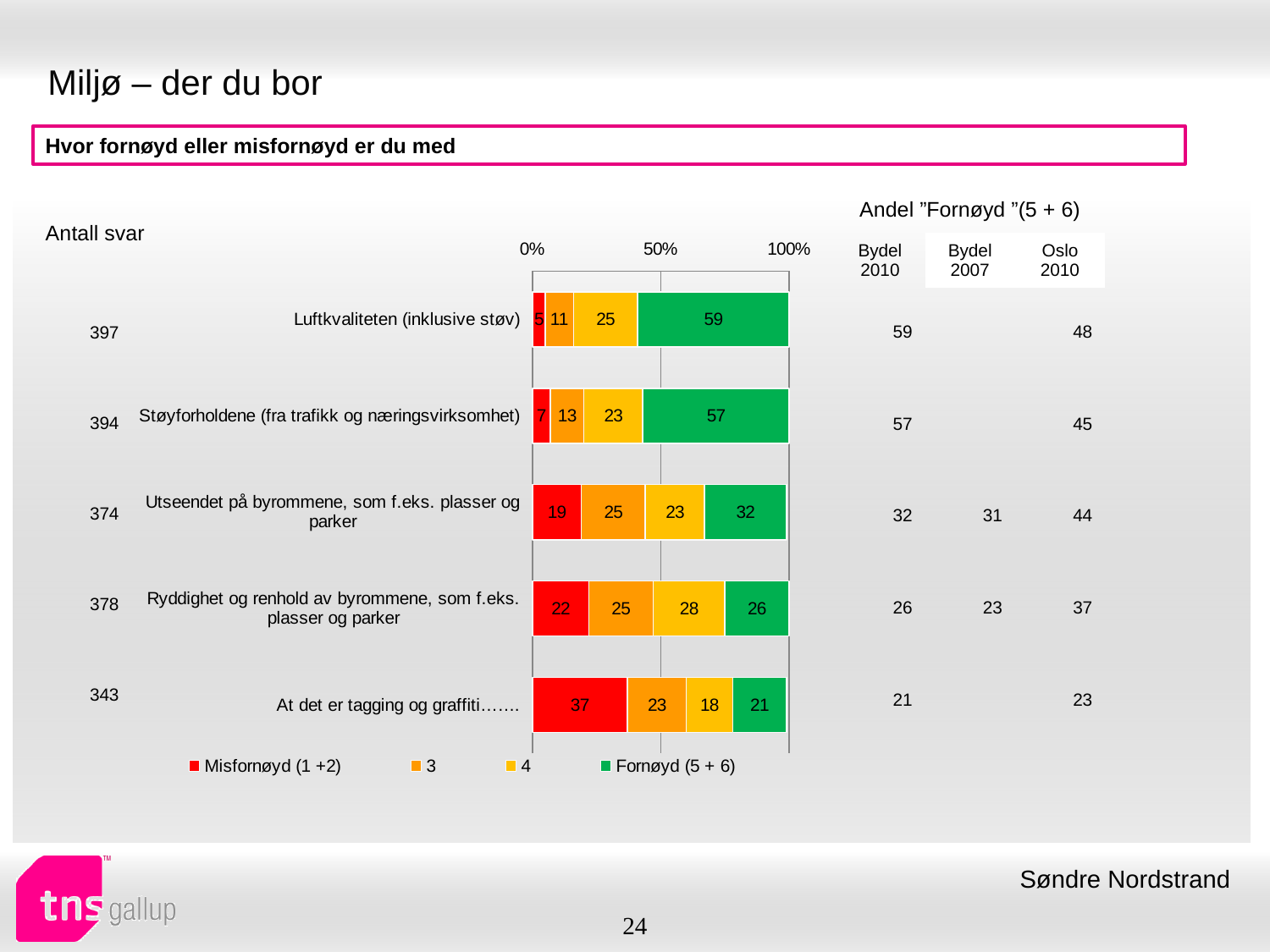
What colour represents the Fornøyd (5 + 6) series in the chart? Green Which category has the lowest Misfornøyd (1 +2) value? Luftkvaliteten (inklusive støv) What is the total of the stacked bar for At det er tagging og graffiti…? 99 What is the value of series 4 for Ryddighet og renhold av byrommene, som f.eks. plasser og parker? 28 How many series does the chart legend list? 4 What kind of chart is shown on the slide? Stacked bar chart How many categories (questions) are plotted in the chart? 5 What is the Fornøyd (5 + 6) value for Luftkvaliteten (inklusive støv)? 59 Which category has the highest Fornøyd (5 + 6) value? Luftkvaliteten (inklusive støv) What is the Misfornøyd (1 +2) value for At det er tagging og graffiti…? 37 What is the difference between the Fornøyd (5 + 6) values for Støyforholdene (fra trafikk og næringsvirksomhet) and Utseendet på byrommene, som f.eks. plasser og parker? 25 Which is larger: the Misfornøyd (1 +2) value for Utseendet på byrommene, som f.eks. plasser og parker or for Ryddighet og renhold av byrommene, som f.eks. plasser og parker? Ryddighet og renhold av byrommene, som f.eks. plasser og parker